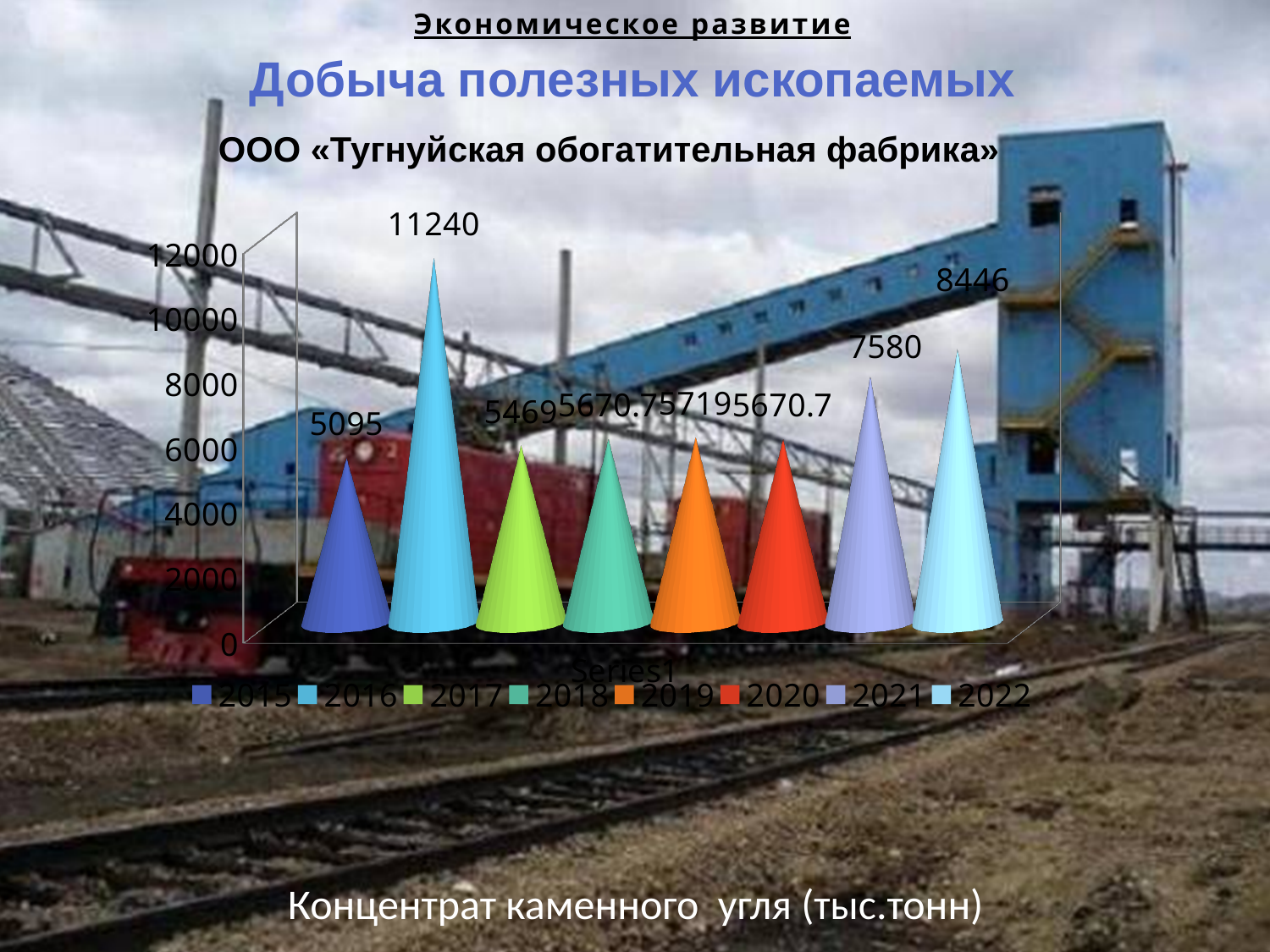
What is the value for 2021 in the chart? 7580 Is the value for 2017 greater or less than 6000? less What is the value for 2015 in the chart? 5095 How many series does the legend list? 8 What is the difference between the values for 2022 and 2021? 866 Which is larger, the value for 2021 or the value for 2022? 2022 What is the difference between the values for 2016 and 2015? 6145 What is the value for 2016 in the chart? 11240 What is the value for 2022 in the chart? 8446 What kind of chart is shown on the slide? bar chart Which year has the lowest value in the chart? 2015 Which year has the highest value in the chart? 2016